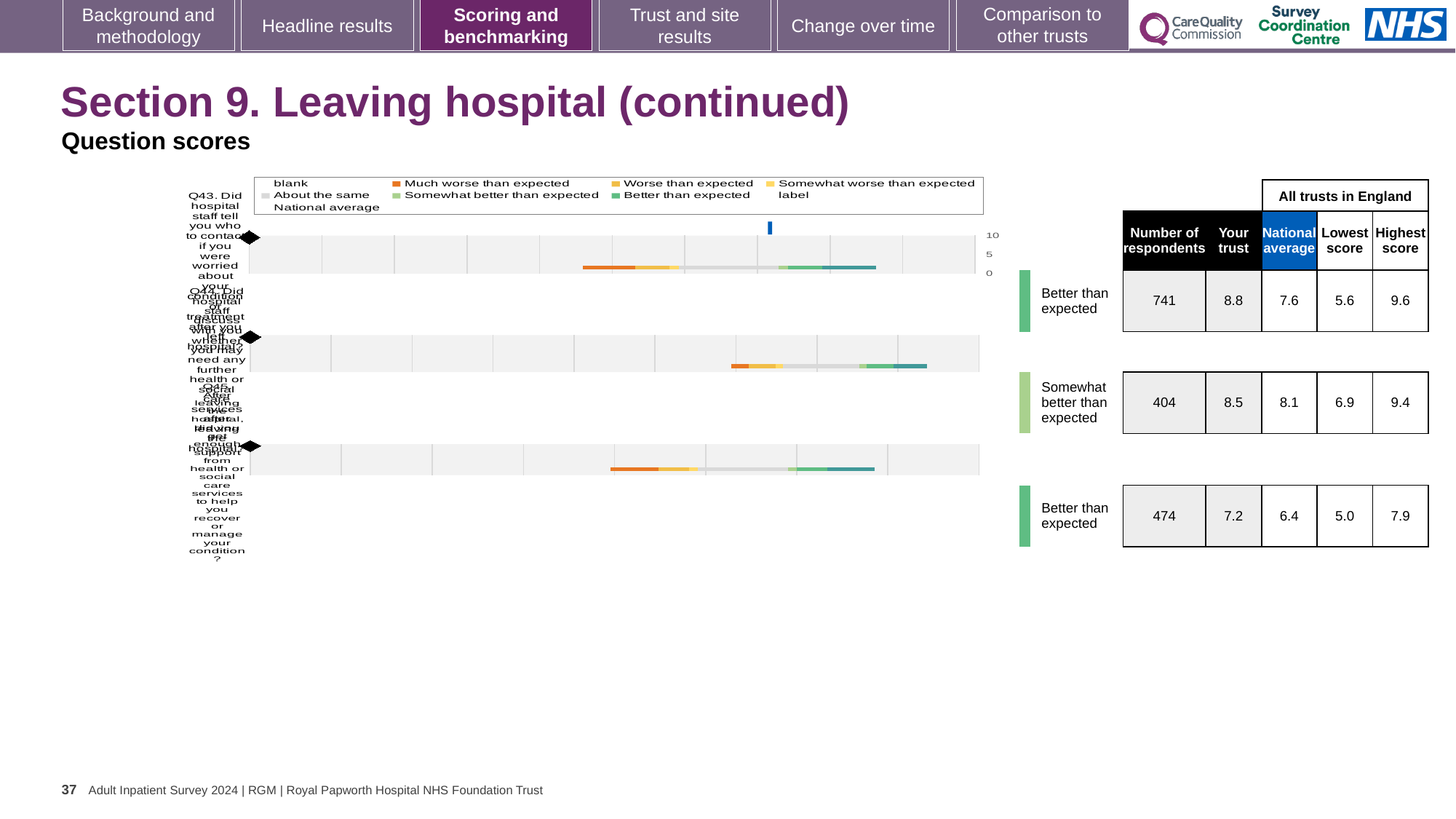
What type of chart is used to show the question scores? Bar chart What benchmark category is given for the second question row? Somewhat better than expected What is the national average score for the first question row (Q43)? 7.6 How many respondents are shown for the first question row (Q43) in the table? 741 Which question row has the highest 'Your trust' score? The first row (Q43), 8.8 Which question row has the lowest number of respondents? The second row, 404 For the third question row, which is larger: the 'Your trust' score or the national average? Your trust (7.2) For the first question row (Q43), how much higher is the 'Your trust' score than the national average? 1.2 How many question rows are plotted on the chart? 3 What is the 'Your trust' score for the first question row (Q43)? 8.8 What is the lowest score among all trusts in England for the third question row? 5.0 What is the highest score among all trusts in England for the second question row? 9.4